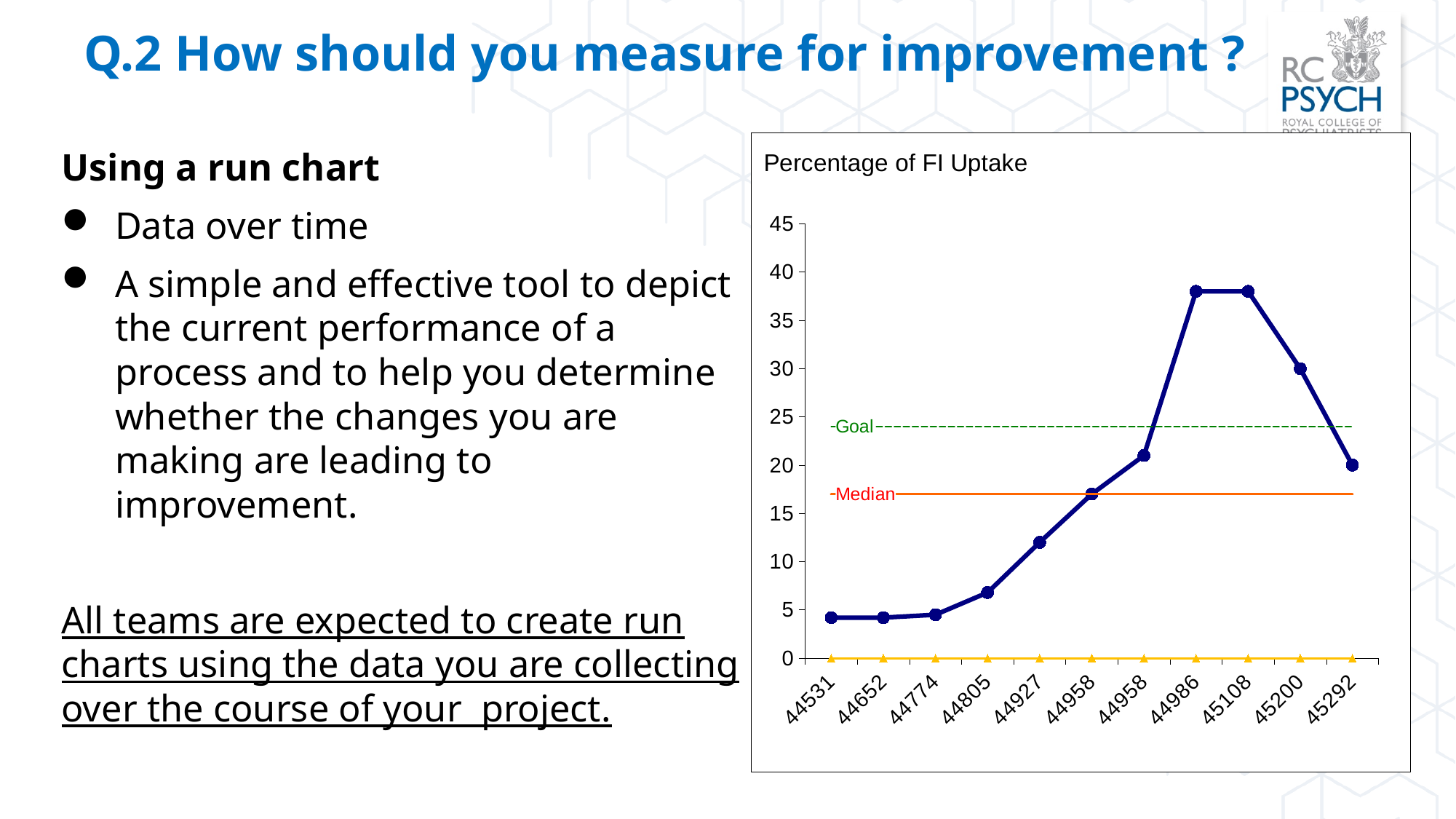
Which has the larger value, 44805 or 44927? 44927 Is the value for 44927 greater or less than 10? greater Is the value for 45292 greater or less than 25? less What is the title of the chart? Percentage of FI Uptake Is the value for 44531 greater or less than 5? less What are the two horizontal reference lines on the chart labelled? Goal and Median What kind of chart is shown on the slide? line chart Which has the larger value, 45200 or 45292? 45200 How many data points are plotted along the x axis of the chart? 11 Do the values rise or fall from 44531 to 44986? rise